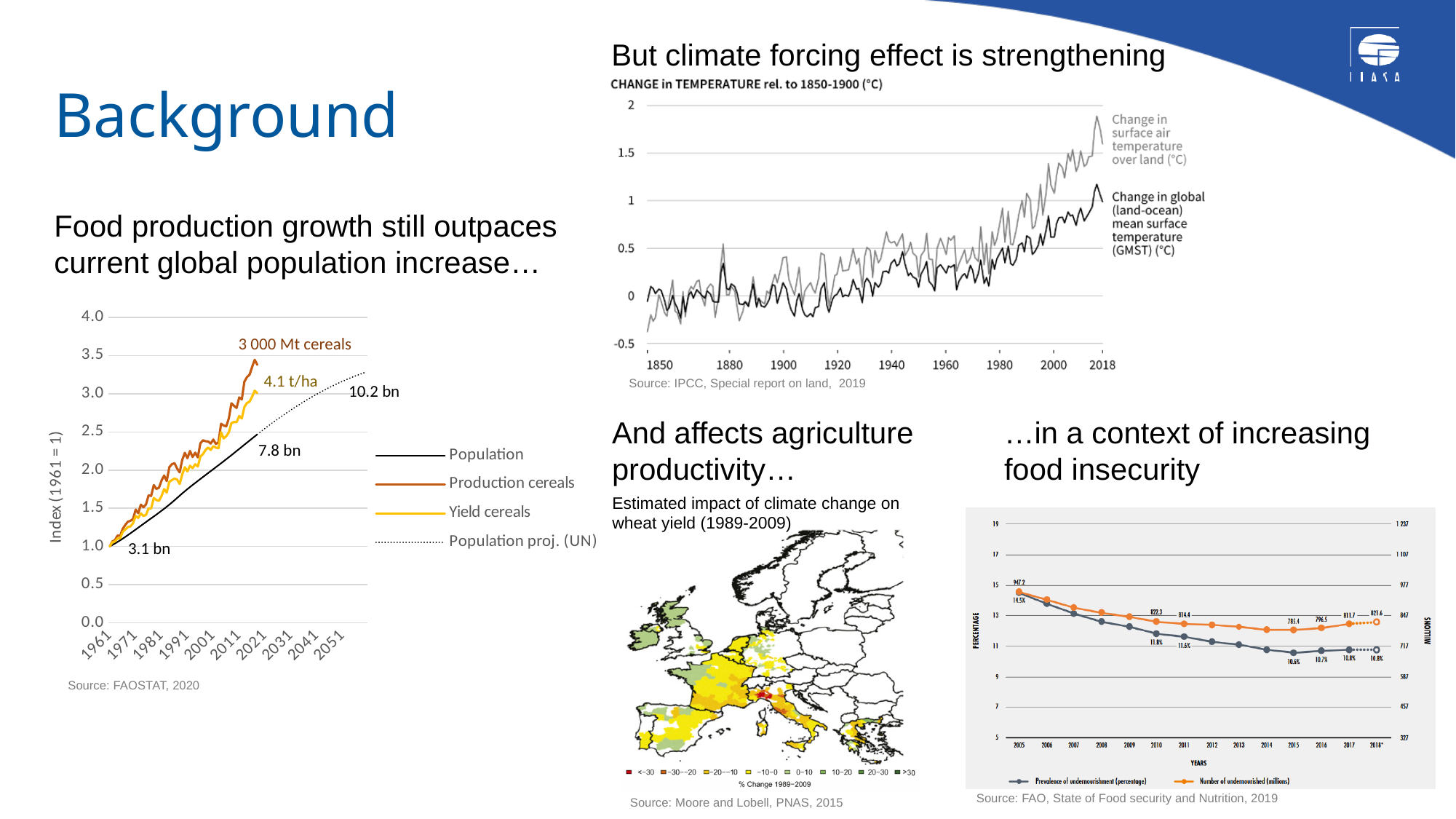
On the FAOSTAT chart at the bottom left, how many series does the legend list? 4 On the FAO undernourishment chart at the bottom right, what is the number of undernourished (millions) in 2005? 947.2 On the FAO undernourishment chart at the bottom right, what is the difference between the number of undernourished in 2018* and in 2015? 36.2 On the IPCC temperature chart at the top right, is the change in surface air temperature over land at its 2018 peak greater or less than 1.5? greater On the FAOSTAT chart at the bottom left, what kind of chart is it? Line chart On the FAOSTAT chart at the bottom left, what population value is annotated for the UN projection at the end of the dotted line? 10.2 bn On the FAO undernourishment chart at the bottom right, how many years are shown on the x axis? 14 On the IPCC temperature chart at the top right, how many series are plotted? 2 On the FAO undernourishment chart at the bottom right, what is the prevalence of undernourishment in 2015? 10.6% On the IPCC temperature chart at the top right, do the temperature changes rise or fall from 1850 to 2018? Rise On the FAOSTAT chart at the bottom left, what cereal yield value is annotated at the end of the Yield cereals line? 4.1 t/ha On the FAOSTAT chart at the bottom left, which series reaches the highest index value by 2021: Production cereals or Population? Production cereals